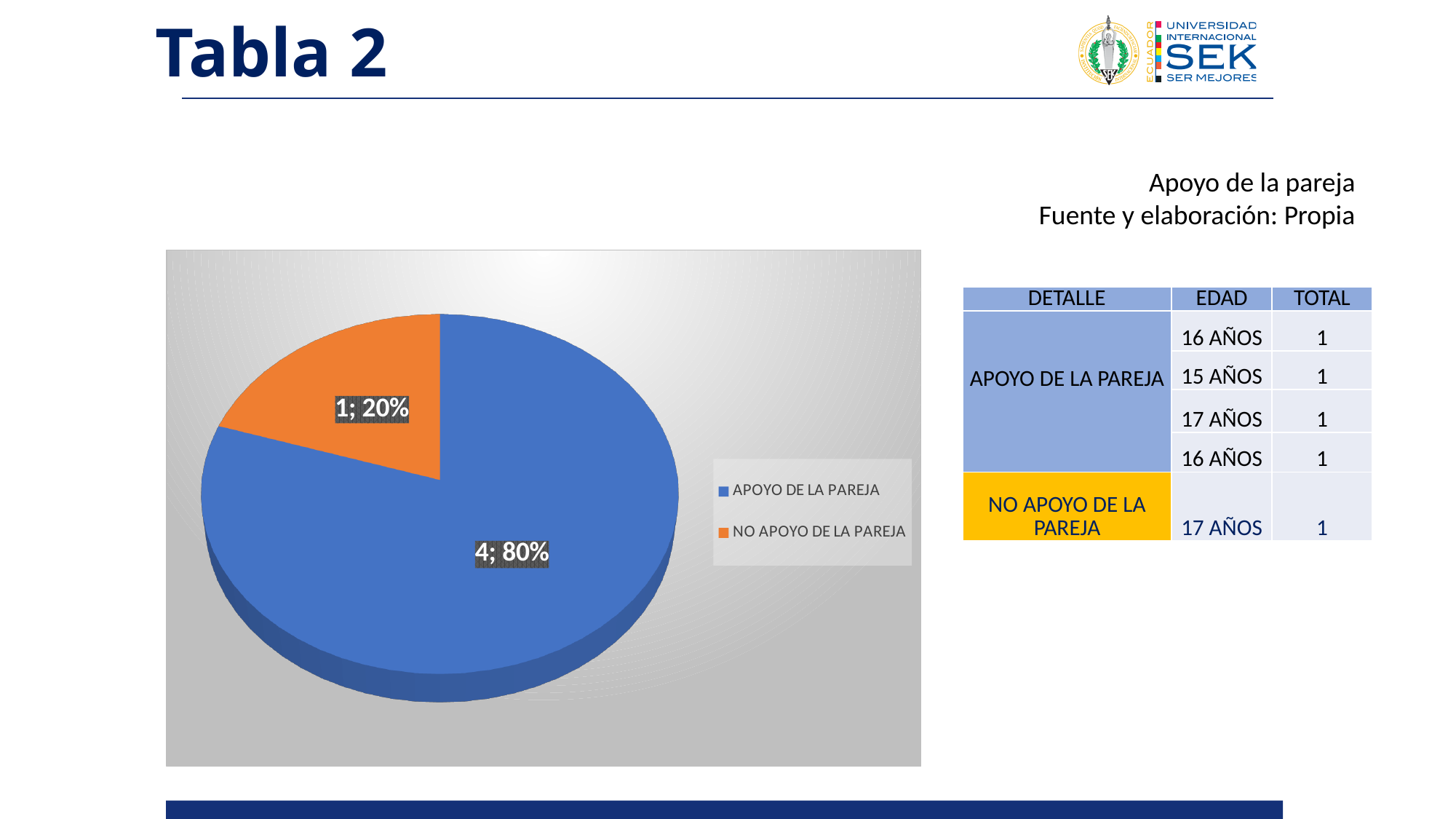
What share of the pie does APOYO DE LA PAREJA represent? 80% What is the count shown for NO APOYO DE LA PAREJA in the pie chart? 1 What kind of chart is shown on the slide? Pie chart How many entries does the pie chart's legend list? 2 Which slice of the pie chart is the smallest? NO APOYO DE LA PAREJA What is the difference between the counts for APOYO DE LA PAREJA and NO APOYO DE LA PAREJA in the pie chart? 3 Which slice of the pie chart is the largest? APOYO DE LA PAREJA What colour is the APOYO DE LA PAREJA slice in the pie chart? Blue What share of the pie does NO APOYO DE LA PAREJA represent? 20% Which is larger in the pie chart, APOYO DE LA PAREJA or NO APOYO DE LA PAREJA? APOYO DE LA PAREJA How many slices does the pie chart have? 2 What is the count shown for APOYO DE LA PAREJA in the pie chart? 4